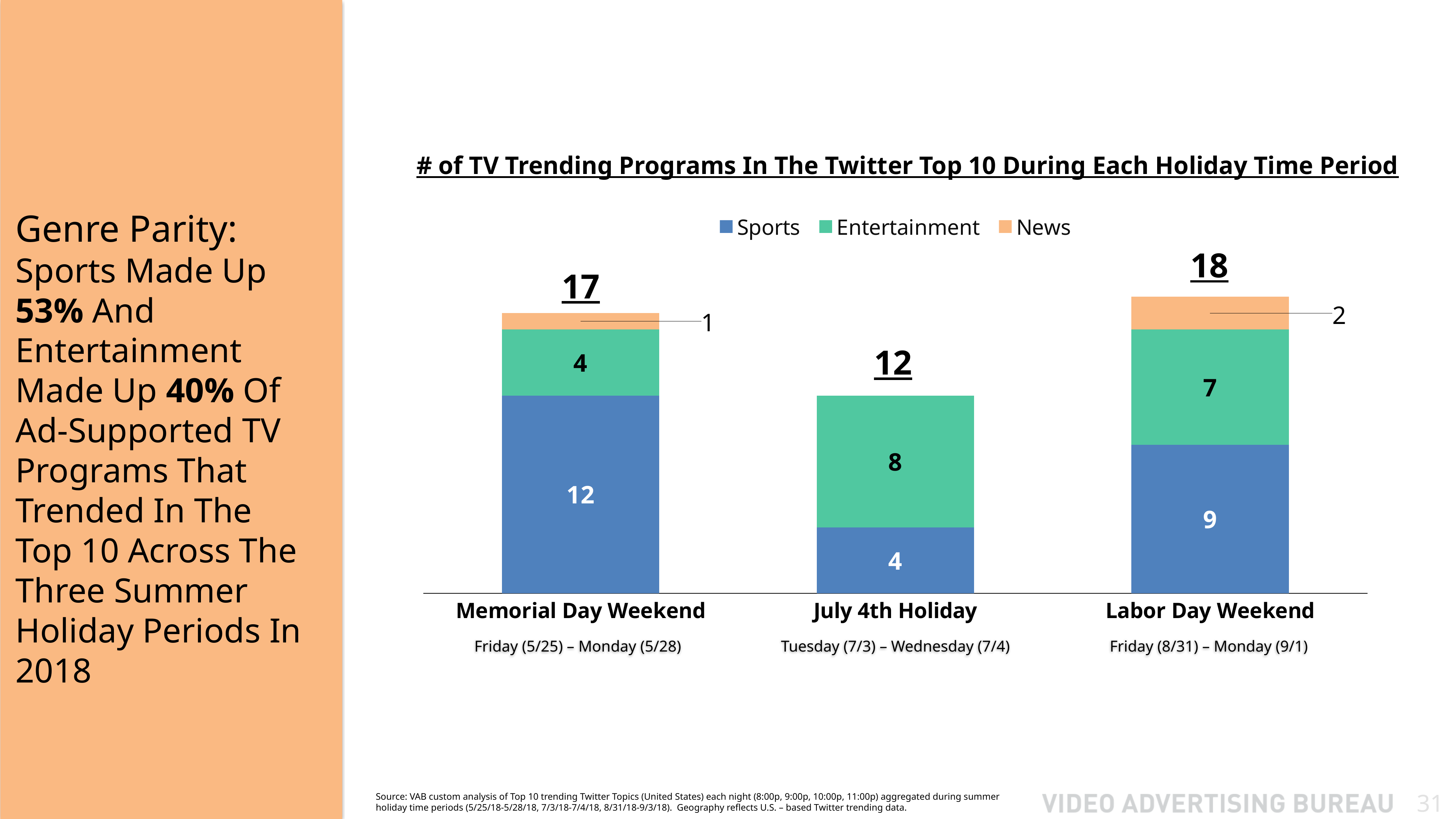
What is the difference between the Sports values for Memorial Day Weekend and July 4th Holiday? 8 What is the Sports value for Memorial Day Weekend? 12 Which series is shown in orange in the legend? News What is the total number of TV trending programs for Labor Day Weekend? 18 How many series does the legend list? 3 What is the Entertainment value for July 4th Holiday? 8 Which is larger, the Entertainment value for Labor Day Weekend or the Entertainment value for Memorial Day Weekend? Labor Day Weekend Which holiday period has the highest total number of TV trending programs? Labor Day Weekend Which holiday period has the lowest total number of TV trending programs? July 4th Holiday How many holiday periods are shown on the x axis? 3 What is the News value for Labor Day Weekend? 2 What kind of chart is shown on the slide? Stacked bar chart